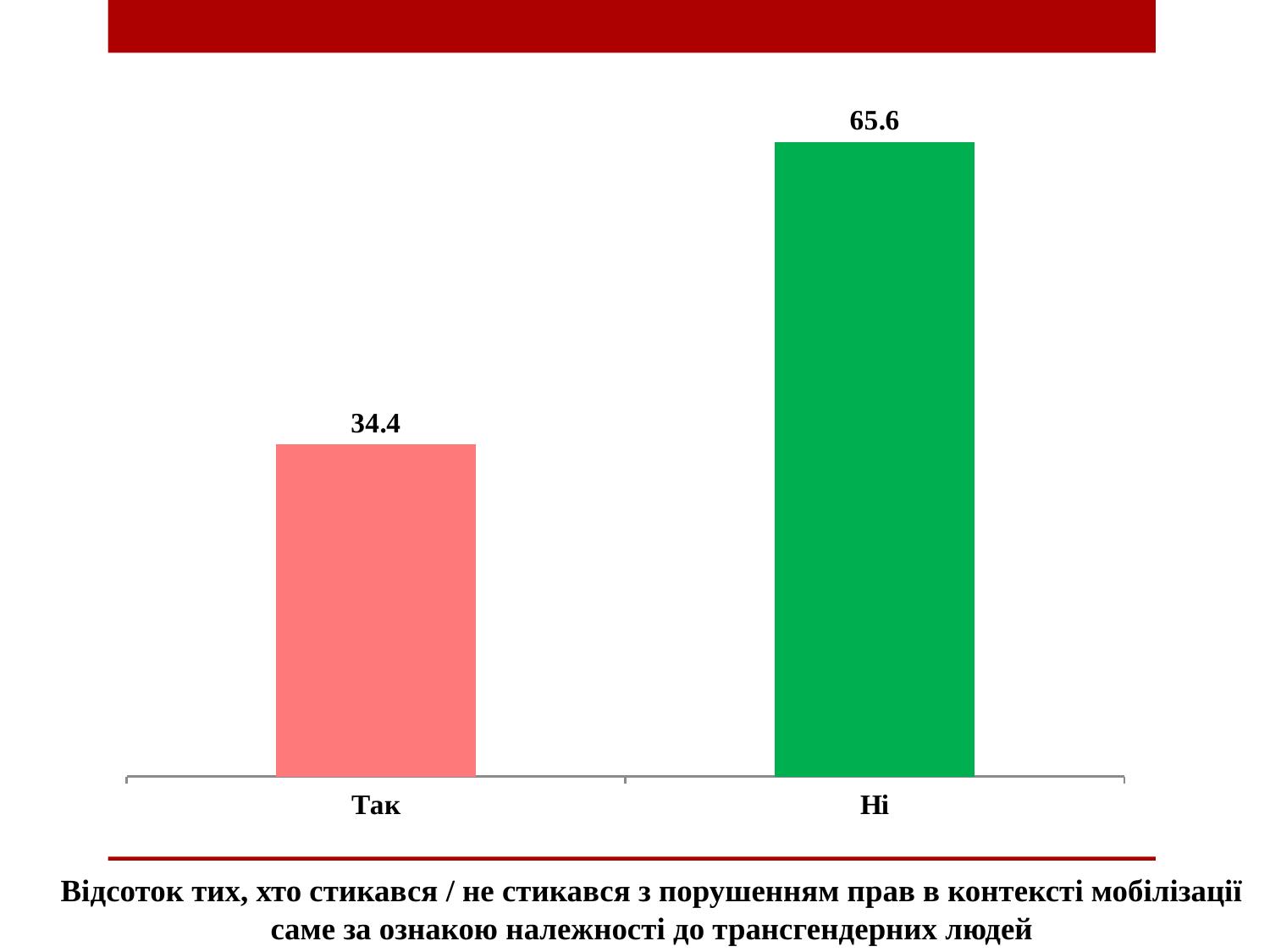
Which is larger, the value for "Так" or the value for "Ні"? Ні What is the difference between the values for "Ні" and "Так"? 31.2 What colour is the bar for "Так"? Pink What kind of chart is shown on the slide? Bar chart Which category has the highest value? Ні How many categories are shown on the chart? 2 What is the value for "Ні"? 65.6 What colour is the bar for "Ні"? Green Which category has the lowest value? Так What is the total of the two values shown on the chart? 100 What is the value for "Так"? 34.4